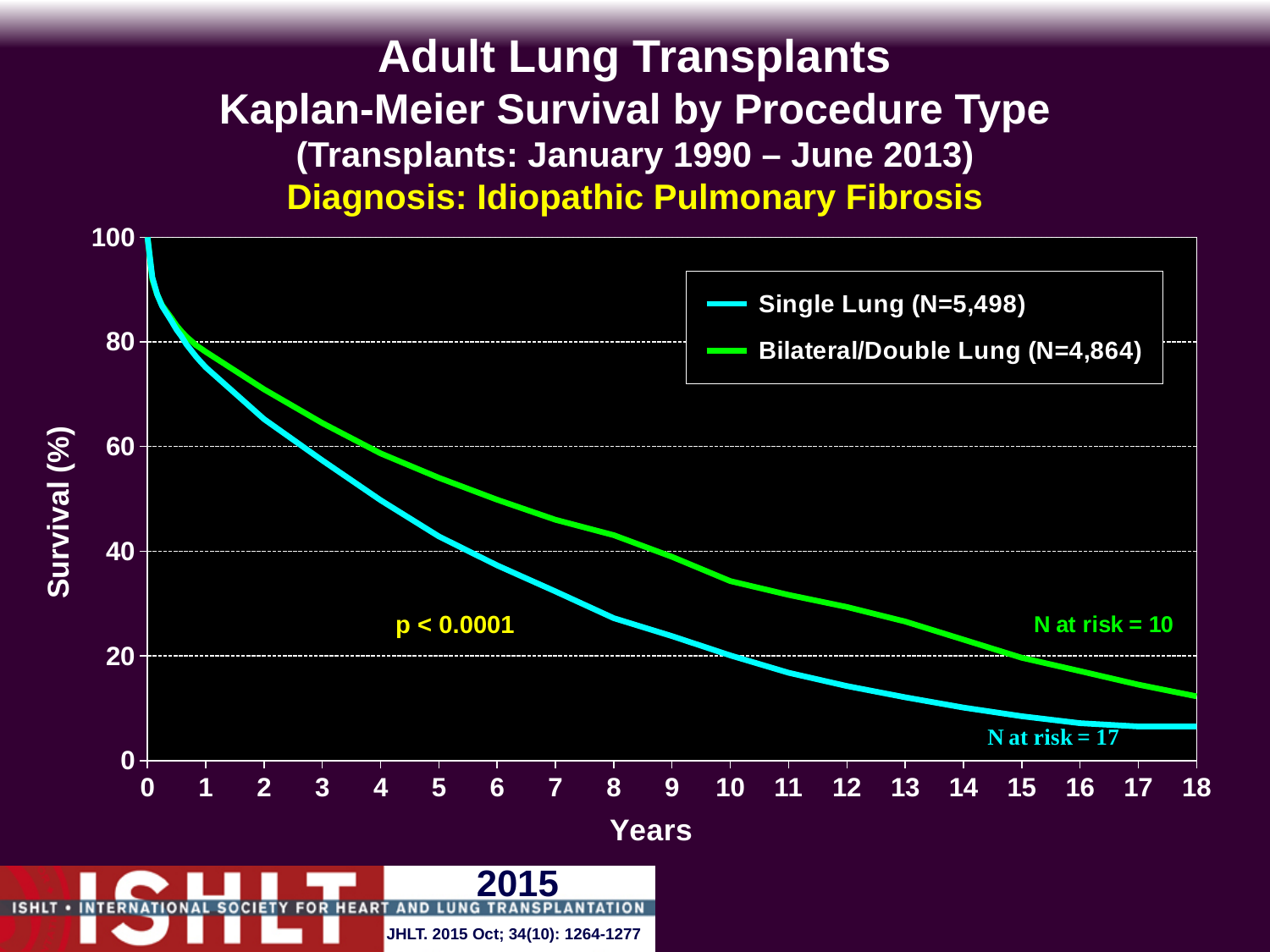
Is the survival value for Bilateral/Double Lung at 18 years greater or less than 20? less How many series does the legend list? 2 At 10 years, which series has the higher survival, Single Lung or Bilateral/Double Lung? Bilateral/Double Lung What is the N at risk value printed next to the Single Lung (cyan) curve? 17 Do the survival curves rise or fall as years increase? fall What is the N for the Bilateral/Double Lung series shown in the legend? 4,864 Is the survival value for Single Lung at 8 years greater or less than 40? less Is the survival value for Bilateral/Double Lung at 5 years greater or less than 40? greater What p-value is printed on the chart? p < 0.0001 What is the N for the Single Lung series shown in the legend? 5,498 What kind of chart is shown on the slide? line chart What is the N at risk value printed next to the Bilateral/Double Lung (green) curve? 10